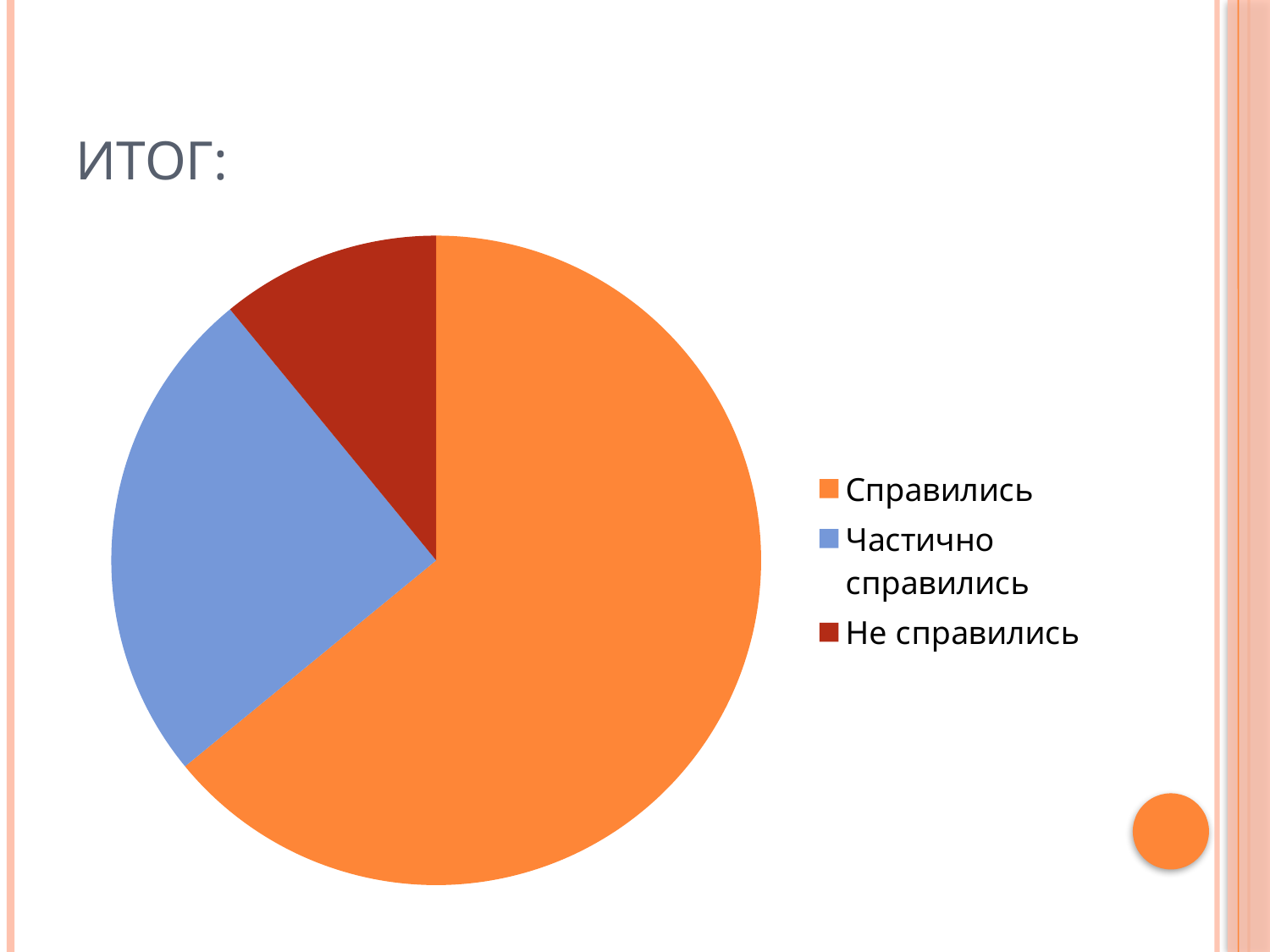
What is the title shown above the pie chart? ИТОГ: What kind of chart is shown on the slide? pie chart Which slice is larger: Справились or Частично справились? Справились Which category has the smallest slice of the pie chart? Не справились What colour is the slice for Частично справились? blue Does the Справились slice take up more or less than half of the pie? more Which category has the largest slice of the pie chart? Справились Which slice is larger: Частично справились or Не справились? Частично справились How many entries does the legend of the pie chart list? 3 How many slices does the pie chart have? 3